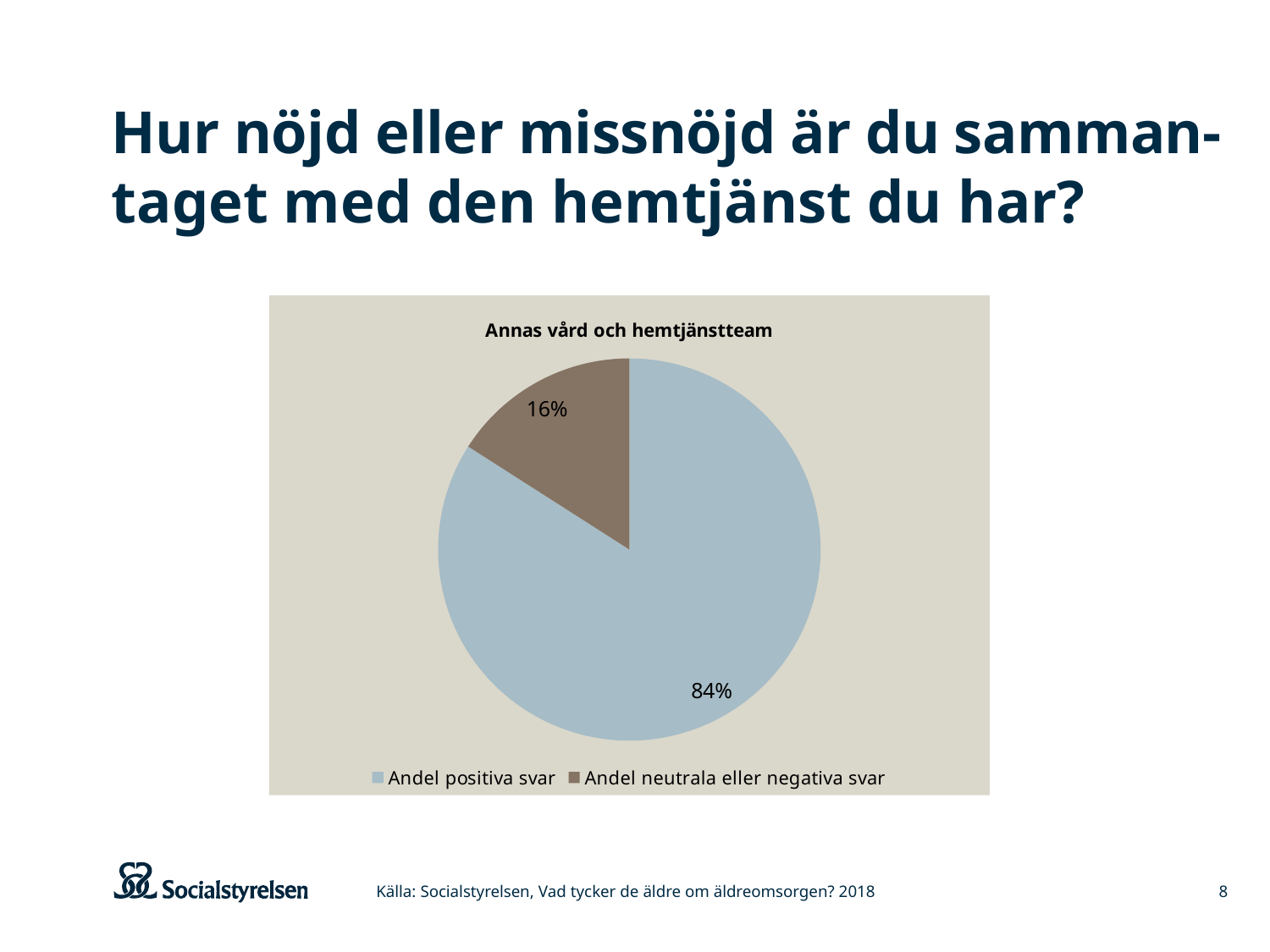
What is the title of the chart? Annas vård och hemtjänstteam What is the difference in percentage points between 'Andel positiva svar' and 'Andel neutrala eller negativa svar'? 68 What colour is the 'Andel neutrala eller negativa svar' slice? brown How many slices does the pie chart have? 2 Which slice is the smallest? Andel neutrala eller negativa svar What share of the pie is 'Andel positiva svar'? 84% What share of the pie is 'Andel neutrala eller negativa svar'? 16% Which is larger, 'Andel positiva svar' or 'Andel neutrala eller negativa svar'? Andel positiva svar Which slice is the largest? Andel positiva svar What type of chart is shown on the slide? pie chart How many entries does the legend list? 2